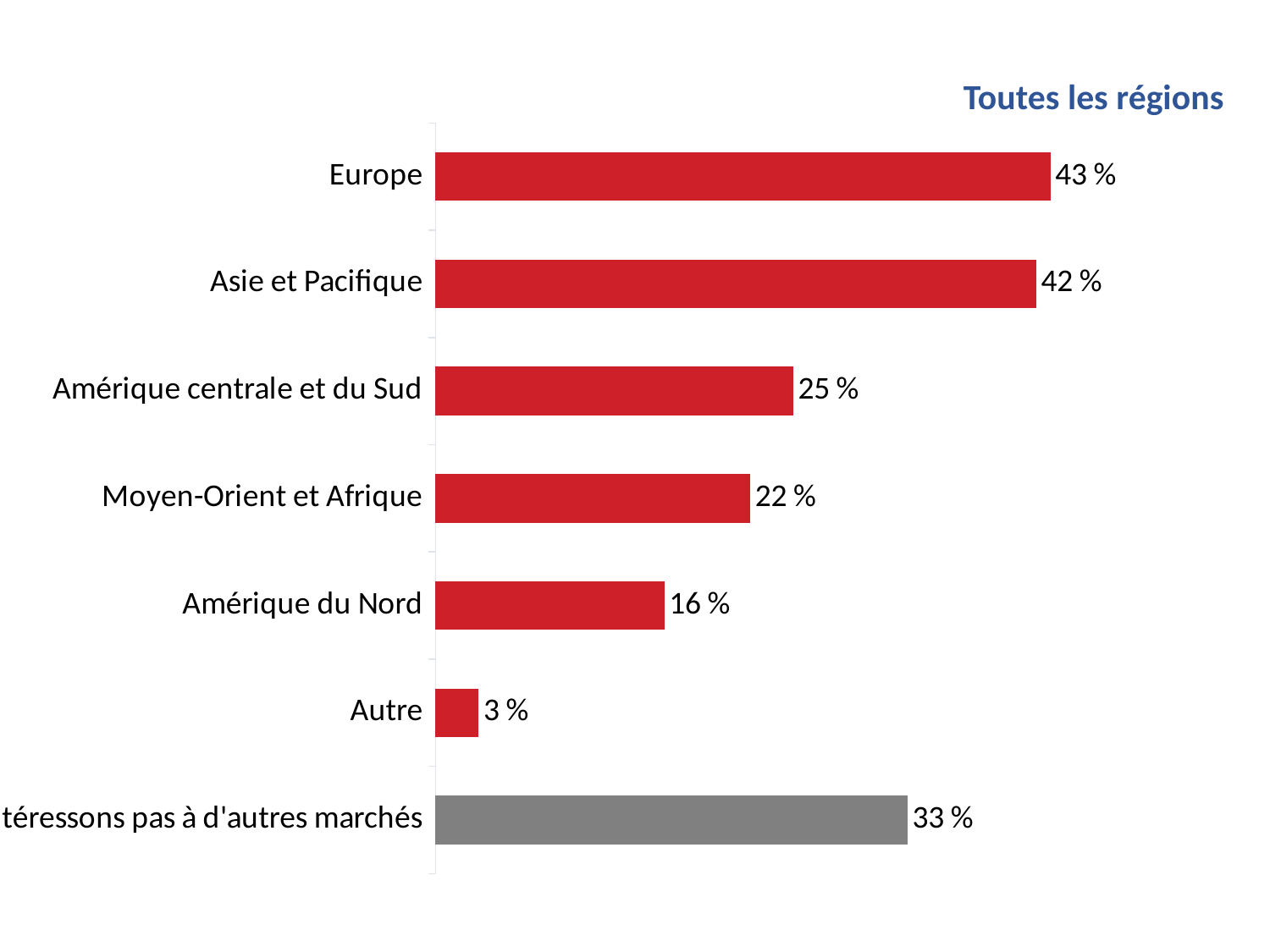
Which is larger, the value for Amérique centrale et du Sud or the value for Moyen-Orient et Afrique? Amérique centrale et du Sud What is the title of the chart? Toutes les régions What is the value for Amérique centrale et du Sud? 25 % What is the value for Amérique du Nord? 16 % What is the value for Moyen-Orient et Afrique? 22 % What type of chart is shown on the slide? bar chart What is the value shown on the grey bar at the bottom of the chart? 33 % What is the value for Asie et Pacifique? 42 % What is the value for Europe? 43 % Which category has the lowest value? Autre What is the value for Autre? 3 % What is the difference between the values for Europe and Amérique du Nord? 27 %